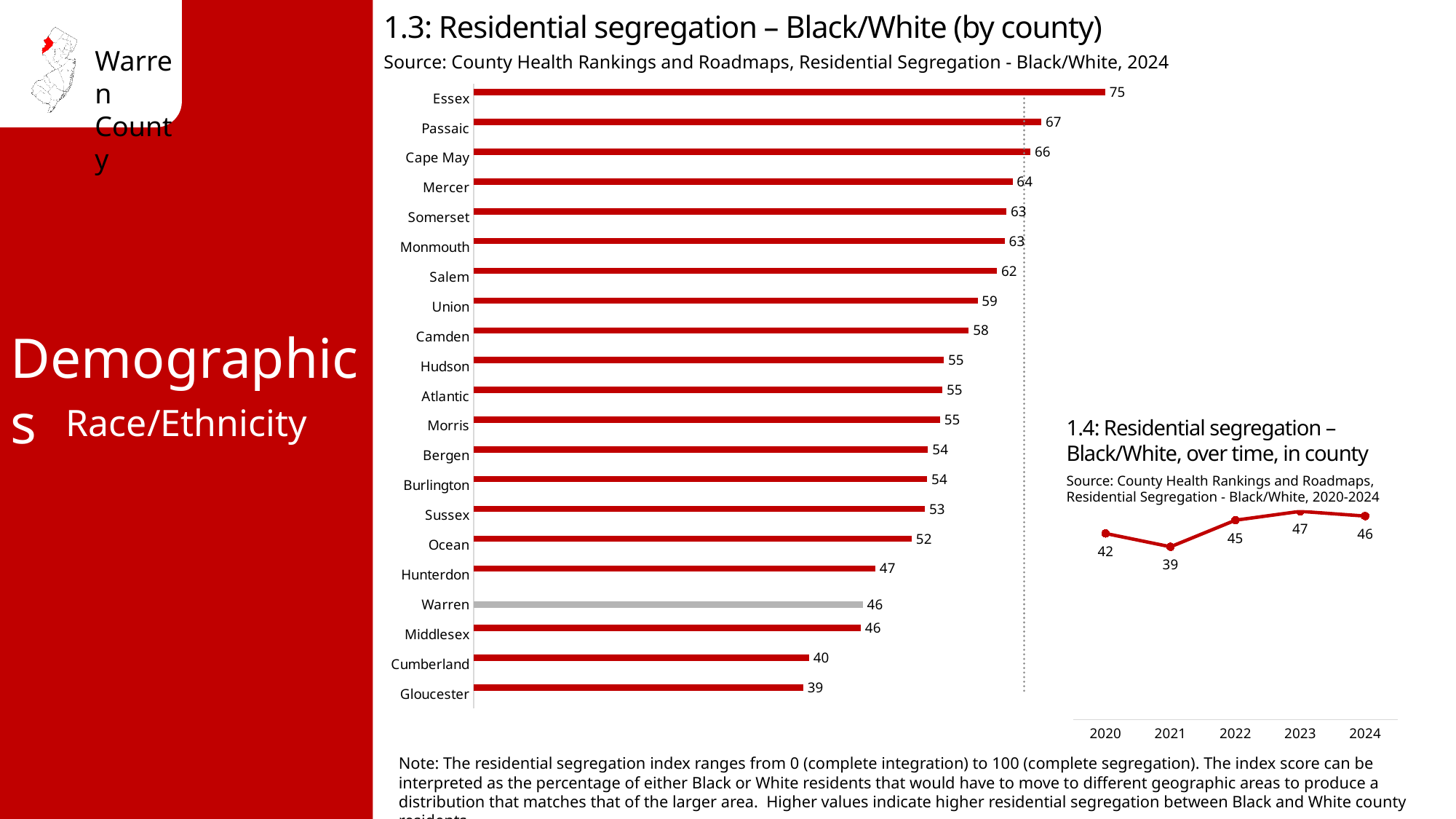
In chart 1.3 (by county), how many counties are shown? 21 In chart 1.4 (Residential segregation – Black/White over time), what is the value for 2021? 39 In chart 1.3 (Residential segregation – Black/White by county), what is the value for Essex? 75 In chart 1.3 (by county), which county has the highest value? Essex In chart 1.3 (by county), which county has the lowest value? Gloucester In chart 1.3 (by county), what is the value for Warren? 46 In chart 1.4 (over time), what is the difference between the values for 2023 and 2020? 5 What kind of chart is chart 1.3 (Residential segregation – Black/White by county)? Bar chart In chart 1.3 (by county), which has a larger value, Passaic or Mercer? Passaic In chart 1.3 (by county), what is the difference between the values for Essex and Gloucester? 36 In chart 1.4 (over time), which year has the highest value? 2023 In chart 1.4 (over time), how many years are plotted? 5